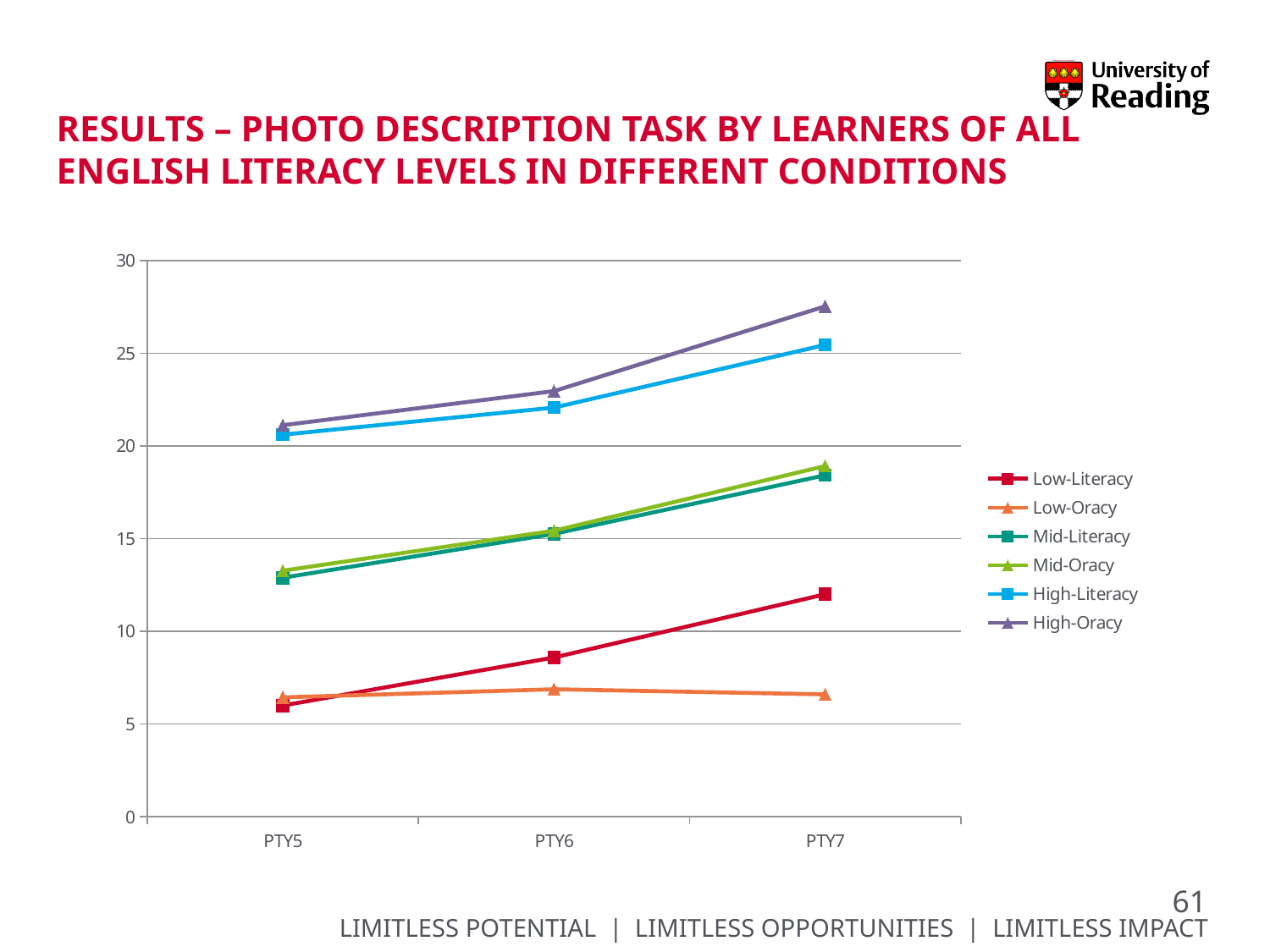
How many categories are shown on the x axis? 3 Do the values for Low-Literacy rise or fall from PTY5 to PTY7? rise Is the value for High-Oracy at PTY7 greater or less than 25? greater Which series has the highest value at PTY7? High-Oracy Is the value for Low-Oracy at PTY6 greater or less than 10? less What kind of chart is shown on the slide? line chart Which series has the lowest value at PTY7? Low-Oracy Is the value for Low-Literacy at PTY5 greater or less than 10? less At PTY7, which is larger: Low-Literacy or Low-Oracy? Low-Literacy What are the three labels on the x axis? PTY5, PTY6, PTY7 How many series does the legend list? 6